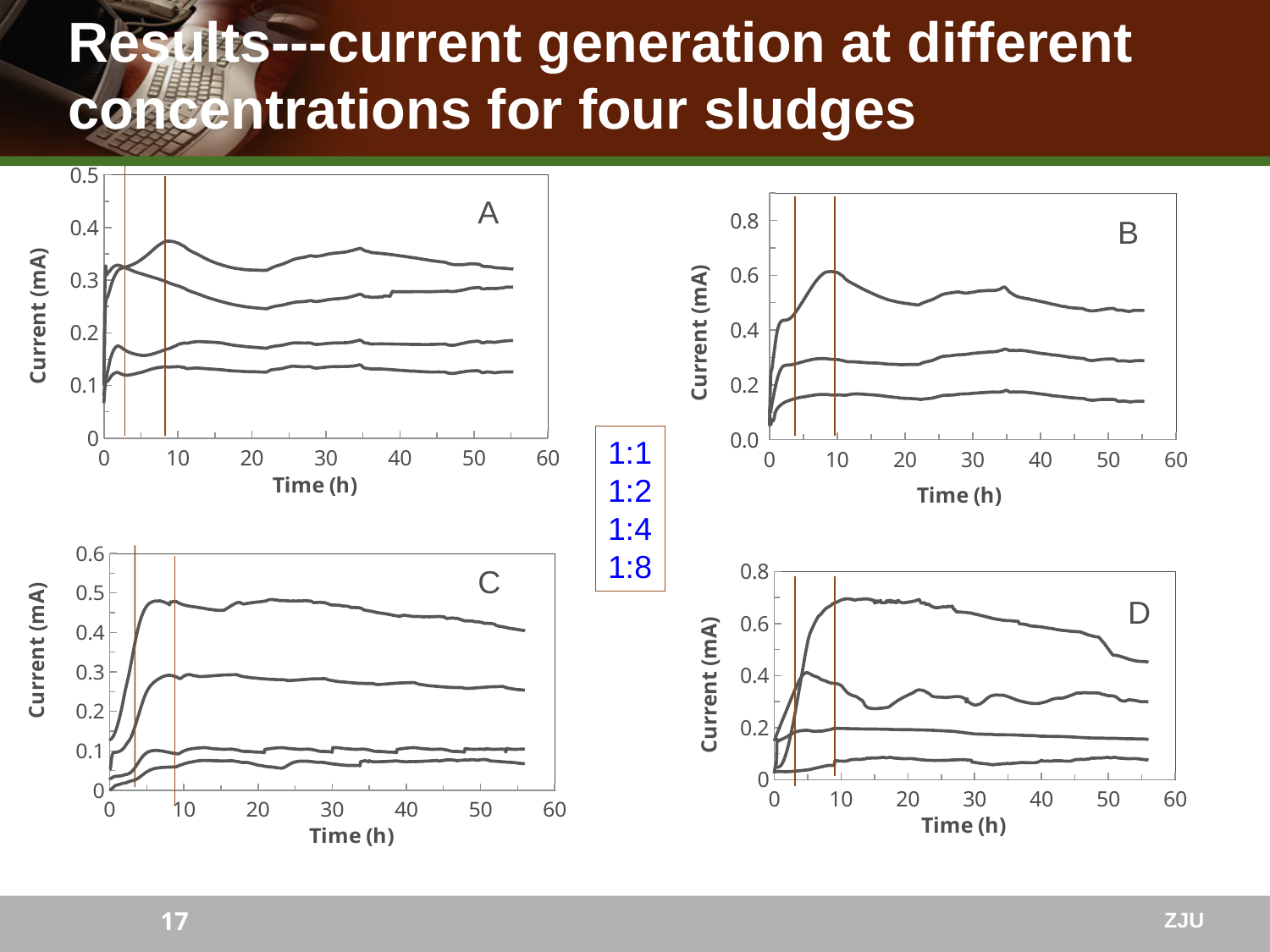
What is the y-axis label on chart B? Current (mA) In chart D, is the value of the highest curve at 20 h greater or less than 0.6? greater In chart B, is the value of the lowest curve at 50 h greater or less than 0.2? less How many charts are shown on the slide? 4 What ratios are listed in the legend? 1:1, 1:2, 1:4, 1:8 In chart A, is the peak of the highest curve greater or less than 0.5? less Which chart has the higher peak for its highest curve, chart A or chart B? chart B How many series does the legend between the charts list? 4 In chart D, does the highest curve rise or fall between 20 h and 55 h? fall What kind of chart is chart A? line chart